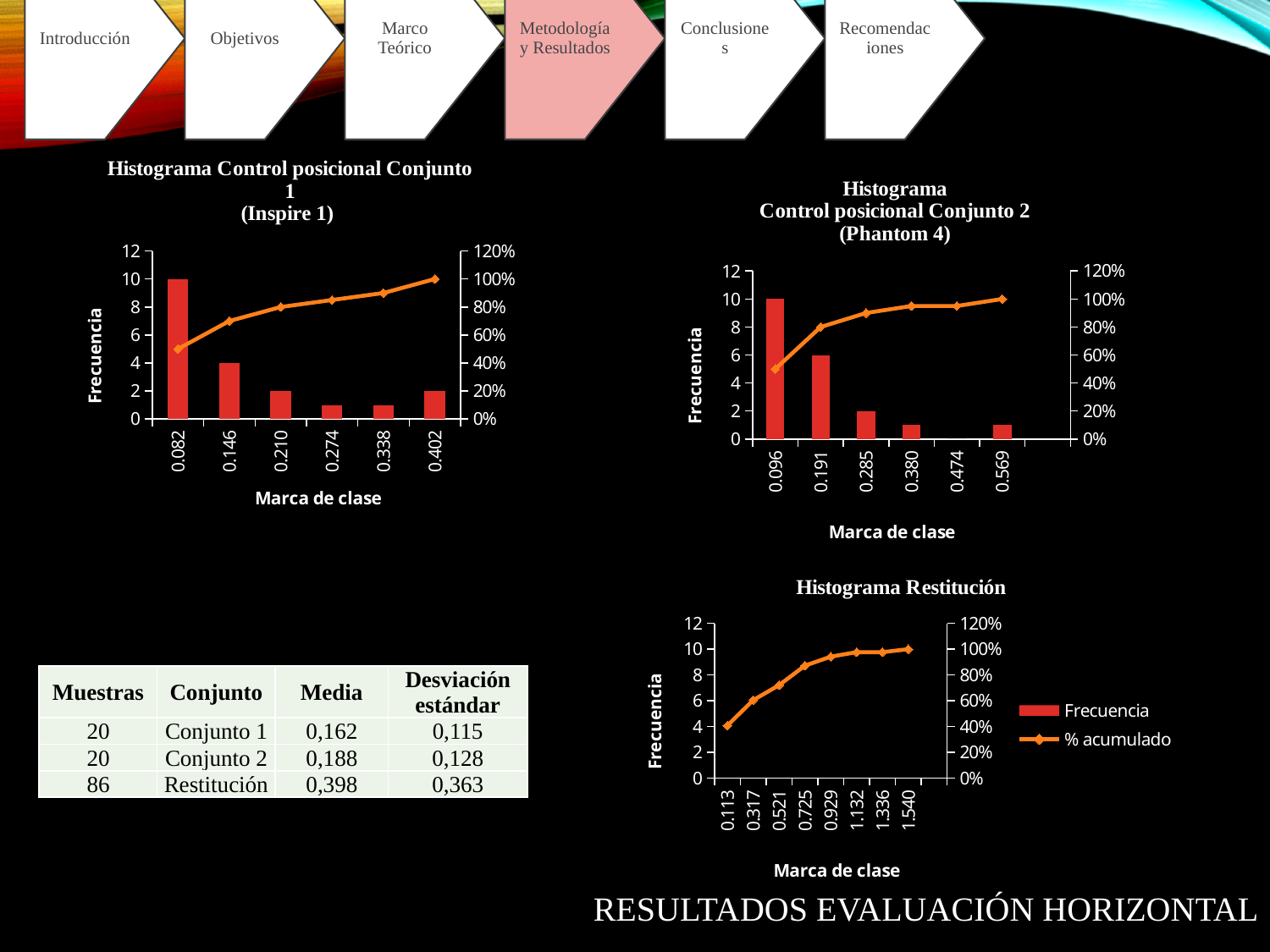
In the 'Histograma Control posicional Conjunto 2 (Phantom 4)' chart, which class mark has the lowest frequency? 0.474 In the 'Histograma Restitución' chart, how many class marks are shown on the x axis? 8 In the 'Histograma Restitución' chart, does the '% acumulado' line rise or fall from left to right? rise In the 'Histograma Control posicional Conjunto 2 (Phantom 4)' chart, what is the frequency for class mark 0.191? 6 In the 'Histograma Control posicional Conjunto 1 (Inspire 1)' chart, which class mark has the highest frequency? 0.082 What kind of chart is the 'Histograma Control posicional Conjunto 1 (Inspire 1)' chart? A bar chart combined with a line chart In the 'Histograma Control posicional Conjunto 2 (Phantom 4)' chart, what is the frequency for class mark 0.096? 10 In the 'Histograma Control posicional Conjunto 1 (Inspire 1)' chart, what is the difference in frequency between class marks 0.082 and 0.146? 6 In the 'Histograma Control posicional Conjunto 1 (Inspire 1)' chart, how many class marks (categories) are shown on the x axis? 6 In the 'Histograma Control posicional Conjunto 1 (Inspire 1)' chart, what is the frequency for class mark 0.082? 10 In the 'Histograma Control posicional Conjunto 2 (Phantom 4)' chart, is the cumulative percentage at class mark 0.285 greater or less than 80%? greater In the 'Histograma Control posicional Conjunto 1 (Inspire 1)' chart, what is the frequency for class mark 0.146? 4